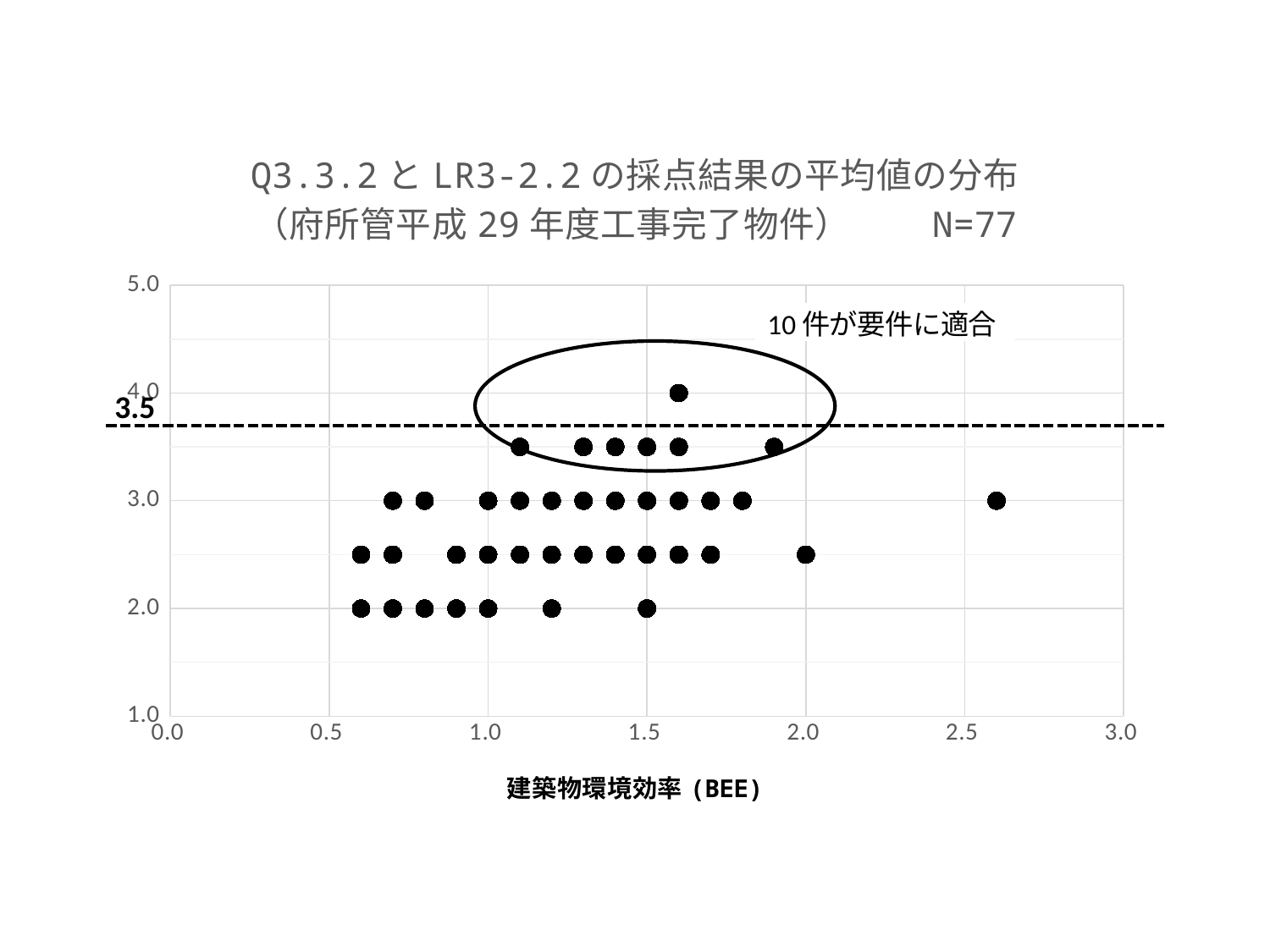
According to the annotation on the chart, how many items meet the requirement (要件に適合)? 10 件 What sample size (N) does the chart title give? N=77 What kind of chart is shown on the slide? scatter plot What is the lowest y-axis value reached by any point on the chart? 2.0 What is the maximum value shown on the y axis of the chart? 5.0 What is the highest y-axis value reached by any point on the chart? 4.0 Is the BEE value of the rightmost point on the chart greater or less than 2.5? greater Is the highest point on the chart greater or less than the 3.5 dashed line? greater What is the label of the x axis of the chart? 建築物環境効率（BEE） What is the value marked by the dashed horizontal line on the chart? 3.5 Is the BEE value of the rightmost point on the chart greater or less than 3.0? less What is the maximum value shown on the x axis of the chart? 3.0